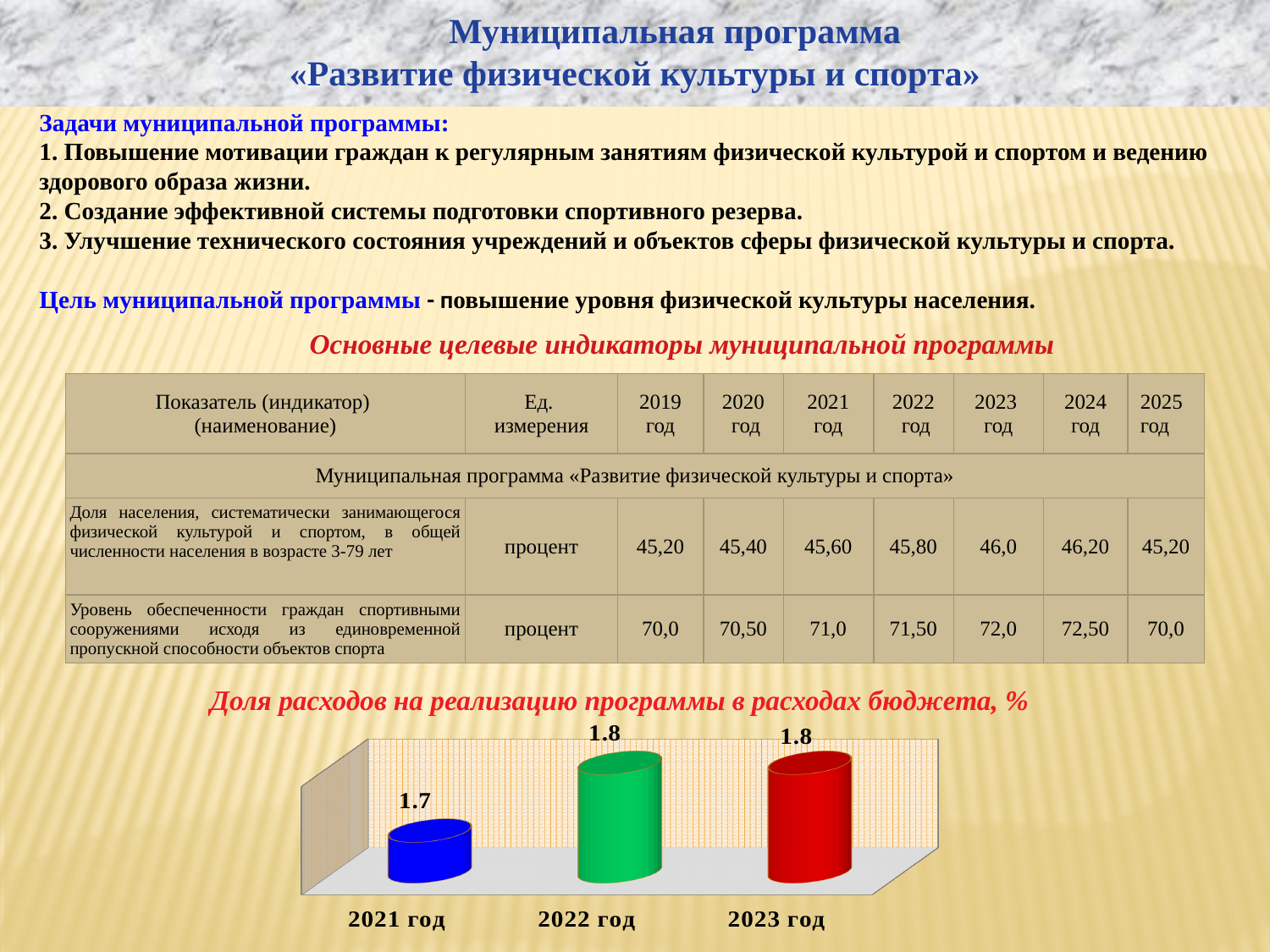
What colour is the bar for 2022 год in the chart 'Доля расходов на реализацию программы в расходах бюджета, %'? Green Which year has the lowest value in the chart 'Доля расходов на реализацию программы в расходах бюджета, %'? 2021 год What is the value for 2023 год in the chart 'Доля расходов на реализацию программы в расходах бюджета, %'? 1.8 Does the value rise or fall from 2021 год to 2022 год in the chart 'Доля расходов на реализацию программы в расходах бюджета, %'? Rise How many years are shown in the chart 'Доля расходов на реализацию программы в расходах бюджета, %'? 3 Are the values for 2022 год and 2023 год equal in the chart 'Доля расходов на реализацию программы в расходах бюджета, %'? Yes What is the difference between the values for 2022 год and 2021 год in the chart 'Доля расходов на реализацию программы в расходах бюджета, %'? 0.1 What is the value for 2021 год in the chart 'Доля расходов на реализацию программы в расходах бюджета, %'? 1.7 What is the value for 2022 год in the chart 'Доля расходов на реализацию программы в расходах бюджета, %'? 1.8 Which is larger in the chart 'Доля расходов на реализацию программы в расходах бюджета, %': the value for 2021 год or for 2022 год? 2022 год What kind of chart is 'Доля расходов на реализацию программы в расходах бюджета, %'? Bar chart What is the title of the chart at the bottom of the slide? Доля расходов на реализацию программы в расходах бюджета, %